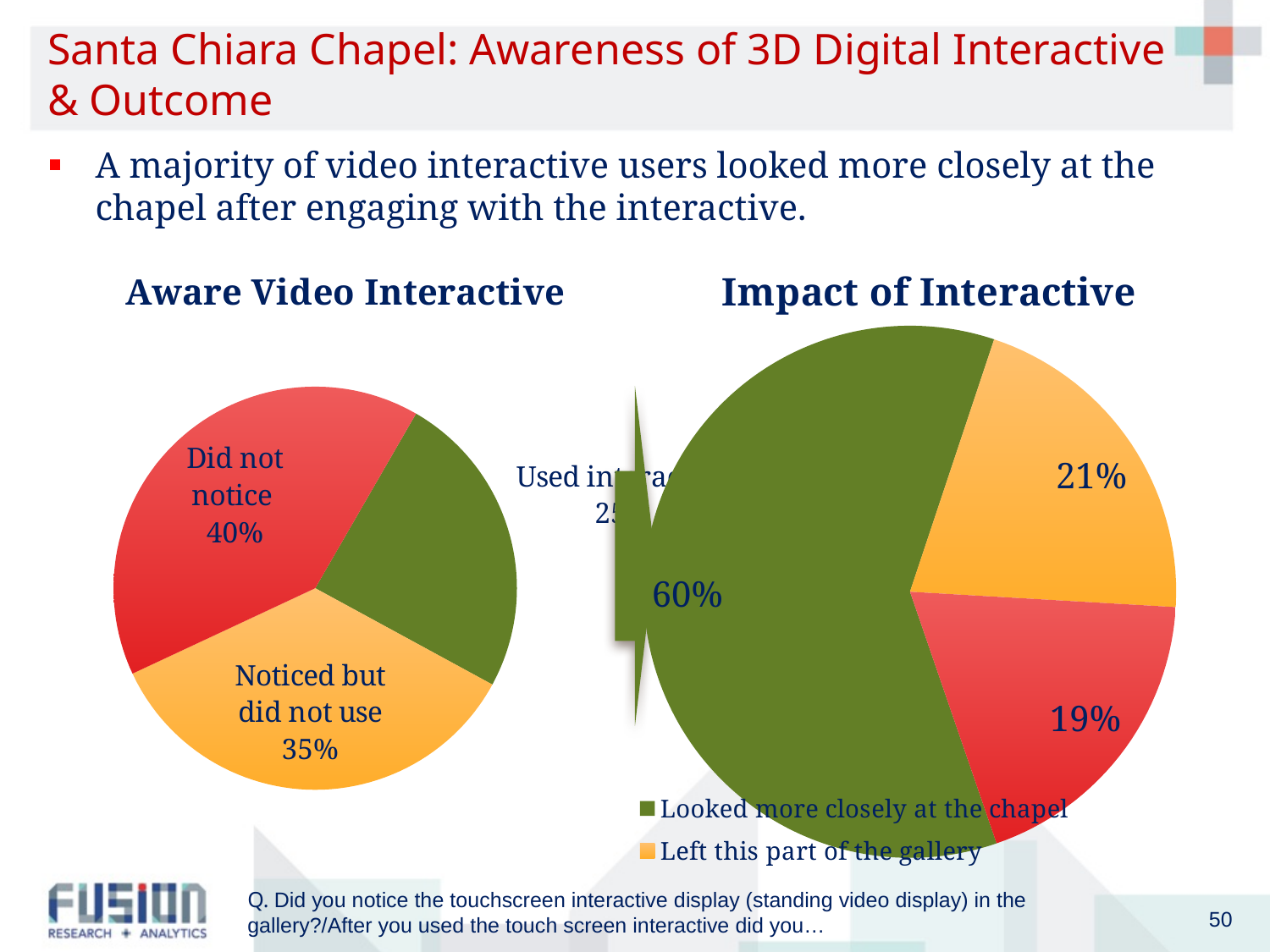
In the Impact of Interactive chart, what percentage left this part of the gallery? 21% In the Impact of Interactive chart, what percentage looked more closely at the chapel? 60% In the Impact of Interactive chart, what is the value shown on the red slice? 19% In the Impact of Interactive chart, what is the difference between 'Looked more closely at the chapel' and 'Left this part of the gallery'? 39 percentage points How many slices does the Aware Video Interactive pie chart have? 3 In the Aware Video Interactive chart, what is the difference between the 'Did not notice' and 'Noticed but did not use' shares? 5 percentage points In the Aware Video Interactive chart, which is larger: 'Did not notice' or 'Noticed but did not use'? Did not notice In the Aware Video Interactive chart, what percentage of visitors did not notice the interactive? 40% In the Aware Video Interactive chart, which labelled slice is the largest? Did not notice What type of chart is the Aware Video Interactive chart? Pie chart In the Aware Video Interactive chart, what percentage noticed but did not use the interactive? 35% In the Impact of Interactive chart, which category has the largest share? Looked more closely at the chapel